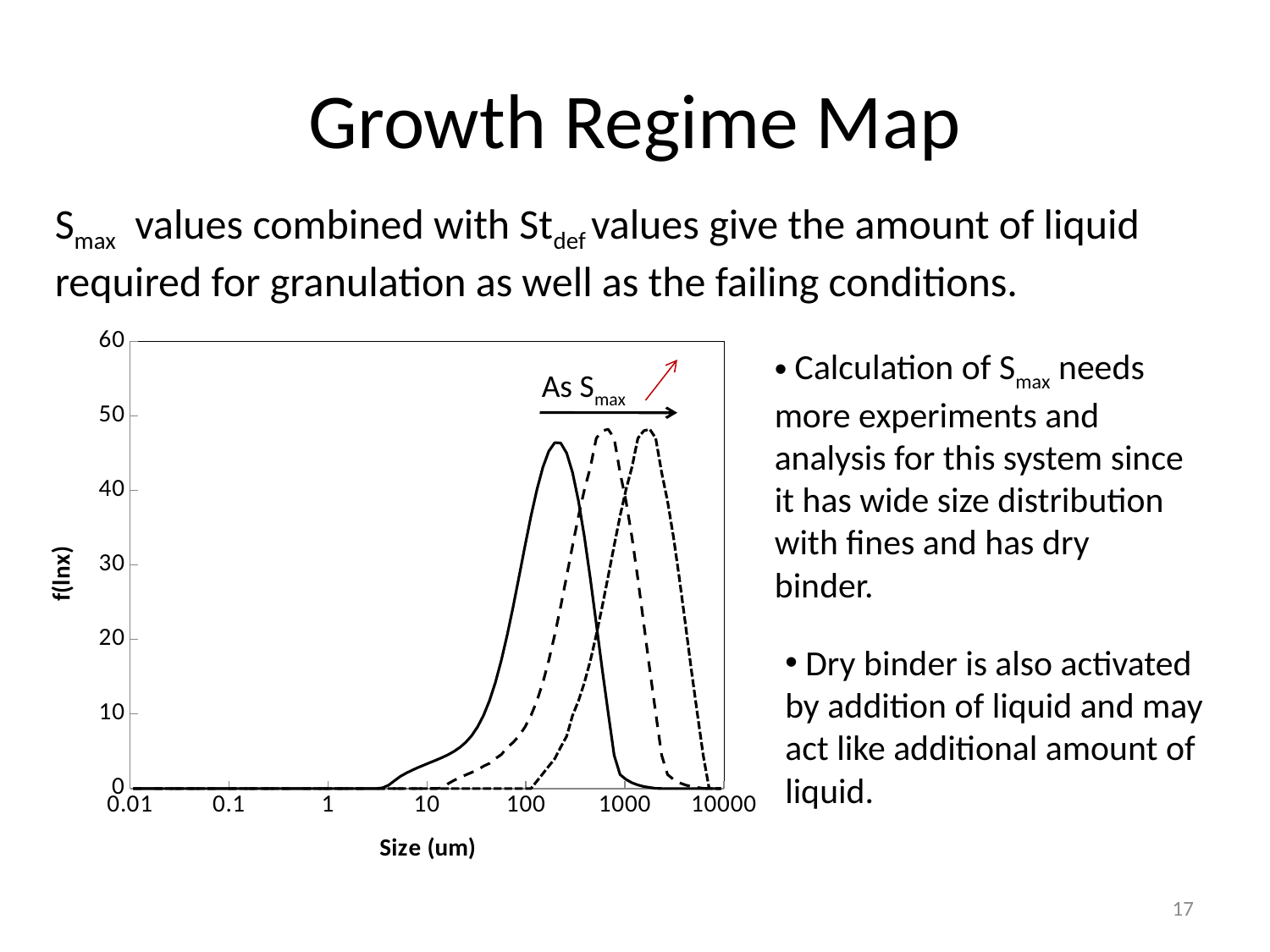
Is the value of the solid curve at a size of 10 um greater or less than 10? less What kind of chart is shown on the slide? line chart What is the label of the y axis of the chart? f(lnx) What is the largest tick value shown on the x axis? 10000 What is the label of the x axis of the chart? Size (um) What is the highest tick value shown on the y axis? 60 How many curves are plotted on the chart? 3 How many tick labels are shown on the x axis? 7 What is the smallest tick value shown on the x axis? 0.01 Is the peak value of the solid curve greater or less than 50? less Is the peak value of the rightmost dashed curve greater or less than 40? greater